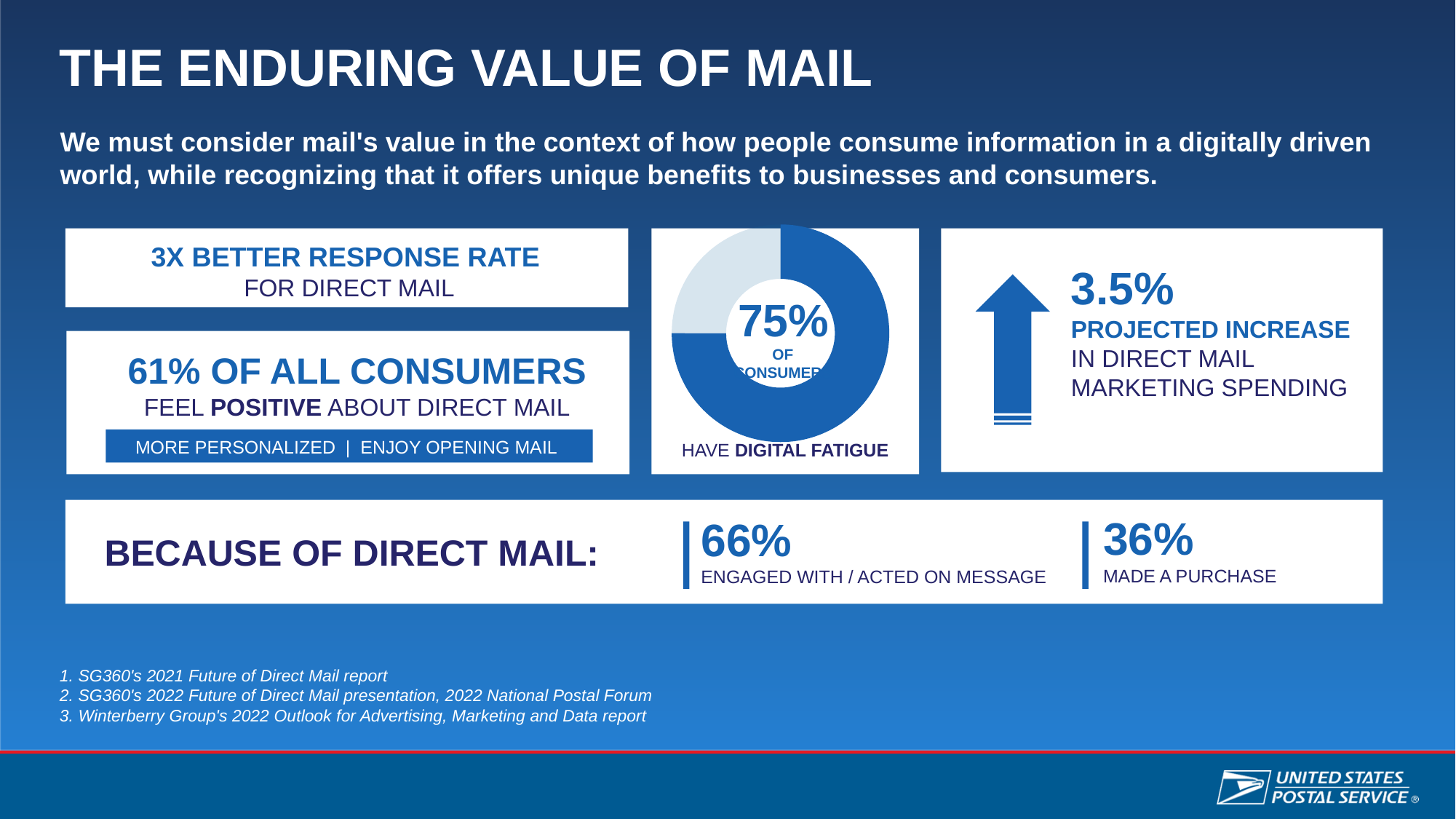
What kind of chart is shown in the middle panel of the slide? donut chart What text is printed in the centre of the donut chart? 75% of consumers Is the value shown in the donut chart greater or less than 50%? greater According to the donut chart, what percentage of consumers have digital fatigue? 75% How many slices does the donut chart have? 2 What condition does the donut chart say 75% of consumers have? digital fatigue In the donut chart, which slice is larger, the dark blue one or the light grey one? dark blue What share of the donut chart is taken by the dark blue slice? 75%